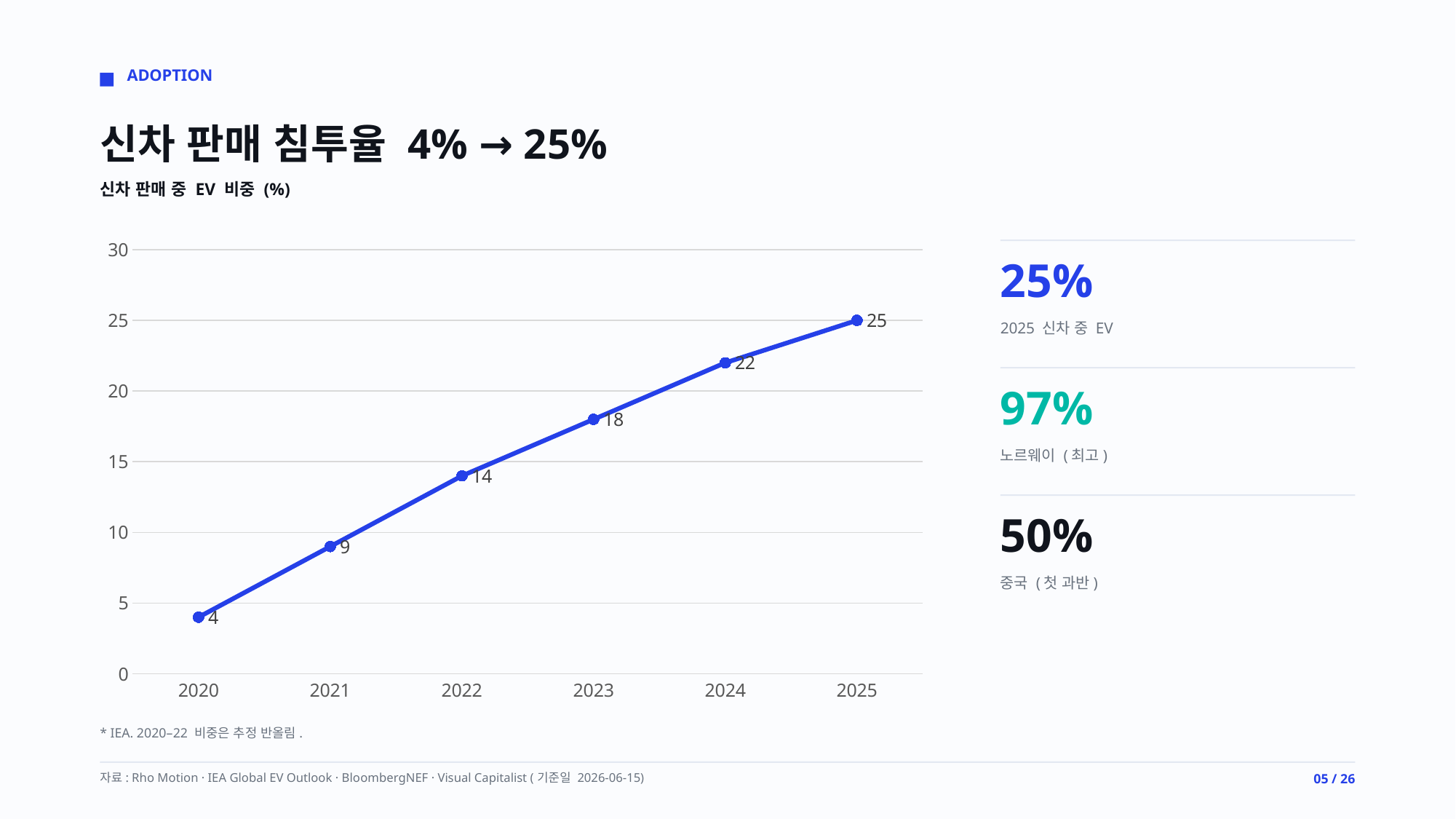
Do the values rise or fall from 2020 to 2025? rise What is the difference between the values for 2025 and 2020? 21 Which is larger, the value for 2024 or the value for 2022? 2024 What is the value for 2023? 18 Which year has the highest value? 2025 What is the difference between the values for 2022 and 2021? 5 Is the value for 2024 greater or less than 20? greater Which year has the lowest value? 2020 What is the value for 2020? 4 What kind of chart is shown on the slide? line chart How many data points are plotted on the chart? 6 What is the value for 2025? 25